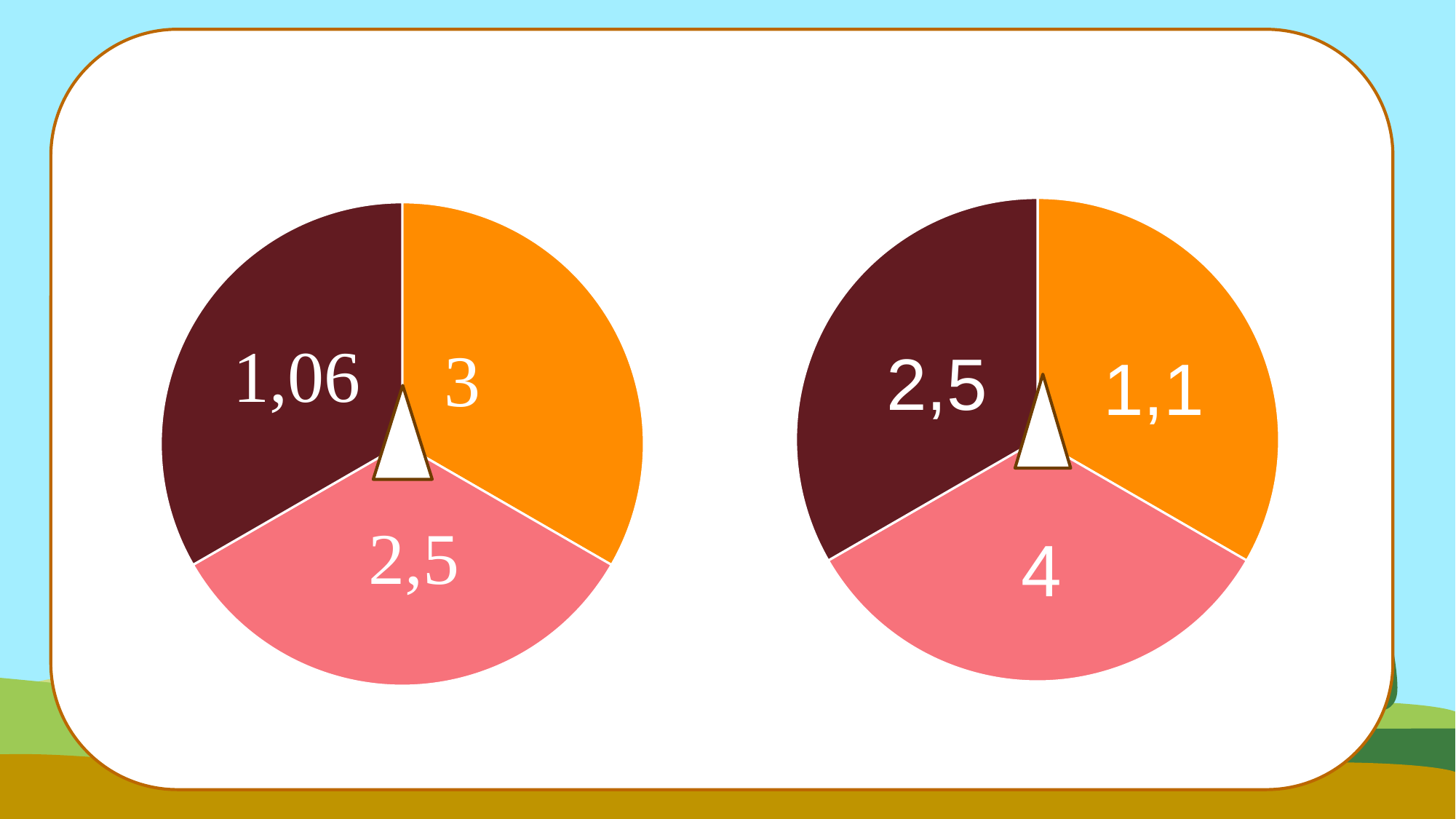
What kind of chart is shown on the left of the slide? Pie chart How many slices does the right pie chart have? 3 How many slices does the left pie chart have? 3 In the right pie chart, which colour slice carries the largest number? Pink In the right pie chart, what number is printed on the orange slice? 1,1 Which is larger: the number on the orange slice of the left pie chart or the number on the orange slice of the right pie chart? Left pie chart (3) In the left pie chart, what number is printed on the dark red slice? 1,06 In the left pie chart, which colour slice carries the smallest number? Dark red In the right pie chart, what number is printed on the pink slice? 4 In the left pie chart, what number is printed on the pink slice? 2,5 In the left pie chart, what number is printed on the orange slice? 3 In the right pie chart, what is the difference between the numbers on the pink slice and the orange slice? 2,9